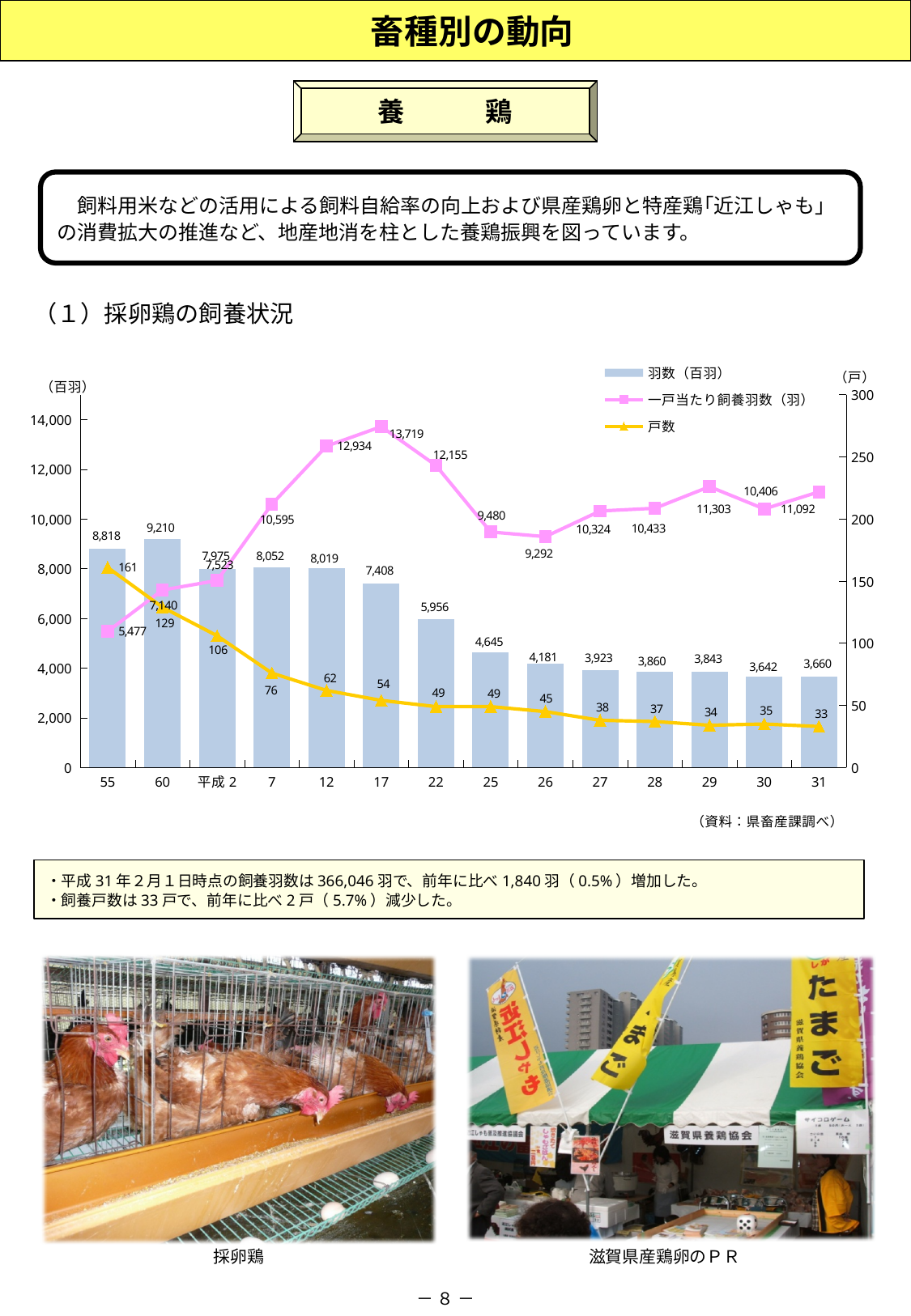
How many years are shown on the x axis of the chart? 14 Which year has the lowest value of 戸数? 31 Does the 戸数 series rise or fall from 55 to 平成31? fall What is the difference in 戸数 between 55 and 60? 32 What is the value of 羽数（百羽） for 平成31? 3,660 What is the value of 戸数 for 平成12? 62 What is the difference in 羽数（百羽） between 平成30 and 平成31? 18 Which year has the highest value of 一戸当たり飼養羽数（羽）? 17 Which is larger, the 一戸当たり飼養羽数（羽） for 平成29 or for 平成31? 平成29 How many series does the legend list? 3 Which year has the highest value of 羽数（百羽）? 60 What is the value of 一戸当たり飼養羽数（羽） for 平成17? 13,719